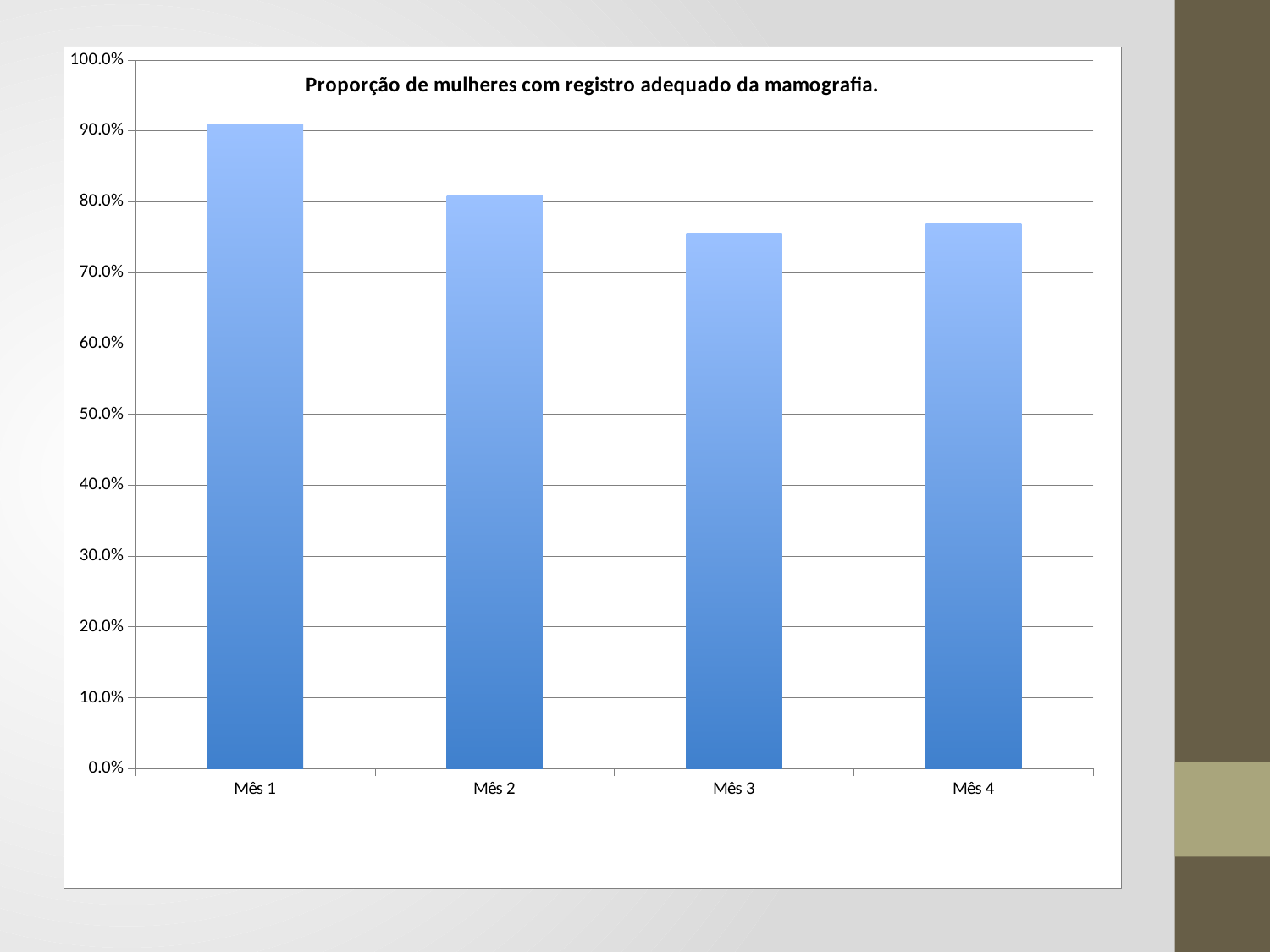
Is the value for Mês 3 greater or less than 80.0%? less Do the values rise or fall from Mês 1 to Mês 3? fall What kind of chart is shown on the slide? bar chart Which is larger, the value for Mês 1 or the value for Mês 2? Mês 1 Is the value for Mês 4 greater or less than 70.0%? greater Which is larger, the value for Mês 2 or the value for Mês 3? Mês 2 Which month has the highest proportion? Mês 1 Is the value for Mês 1 greater or less than 80.0%? greater What is the title of the chart? Proporção de mulheres com registro adequado da mamografia. How many categories (months) are plotted on the x axis? 4 Which is larger, the value for Mês 1 or the value for Mês 4? Mês 1